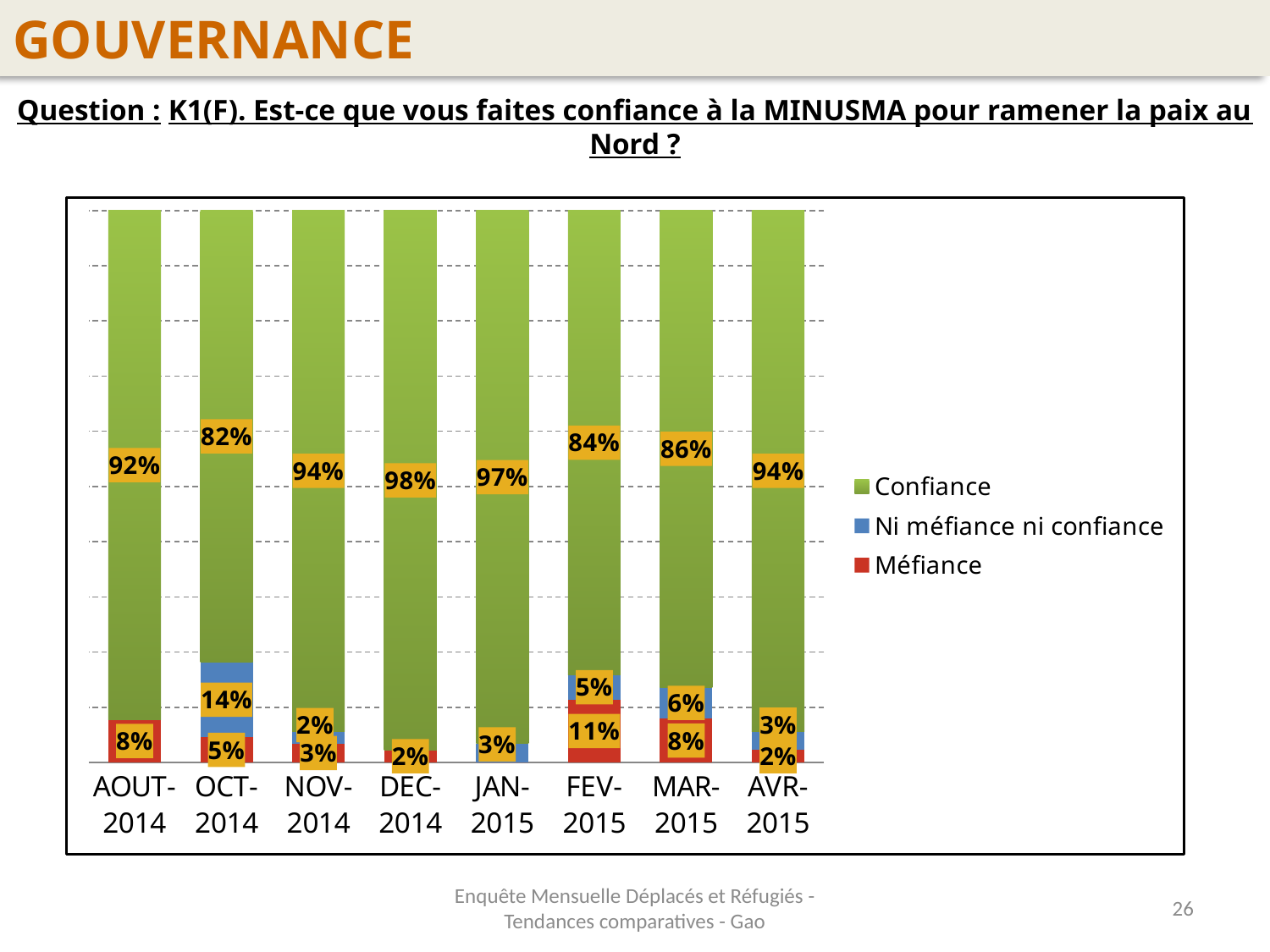
How many months (categories) are shown on the x axis? 8 Which series is shown in green in the legend? Confiance What is the Confiance value for DEC-2014? 98% What is the Méfiance value for FEV-2015? 11% What is the Ni méfiance ni confiance value for OCT-2014? 14% Which is larger, the Méfiance value for AOUT-2014 or for AVR-2015? AOUT-2014 What is the Confiance value for AVR-2015? 94% What is the difference between the Confiance values for JAN-2015 and MAR-2015? 11% Which month has the highest Confiance value? DEC-2014 What type of chart is shown on the slide? stacked bar chart Which month has the lowest Confiance value? OCT-2014 How many series does the legend list? 3